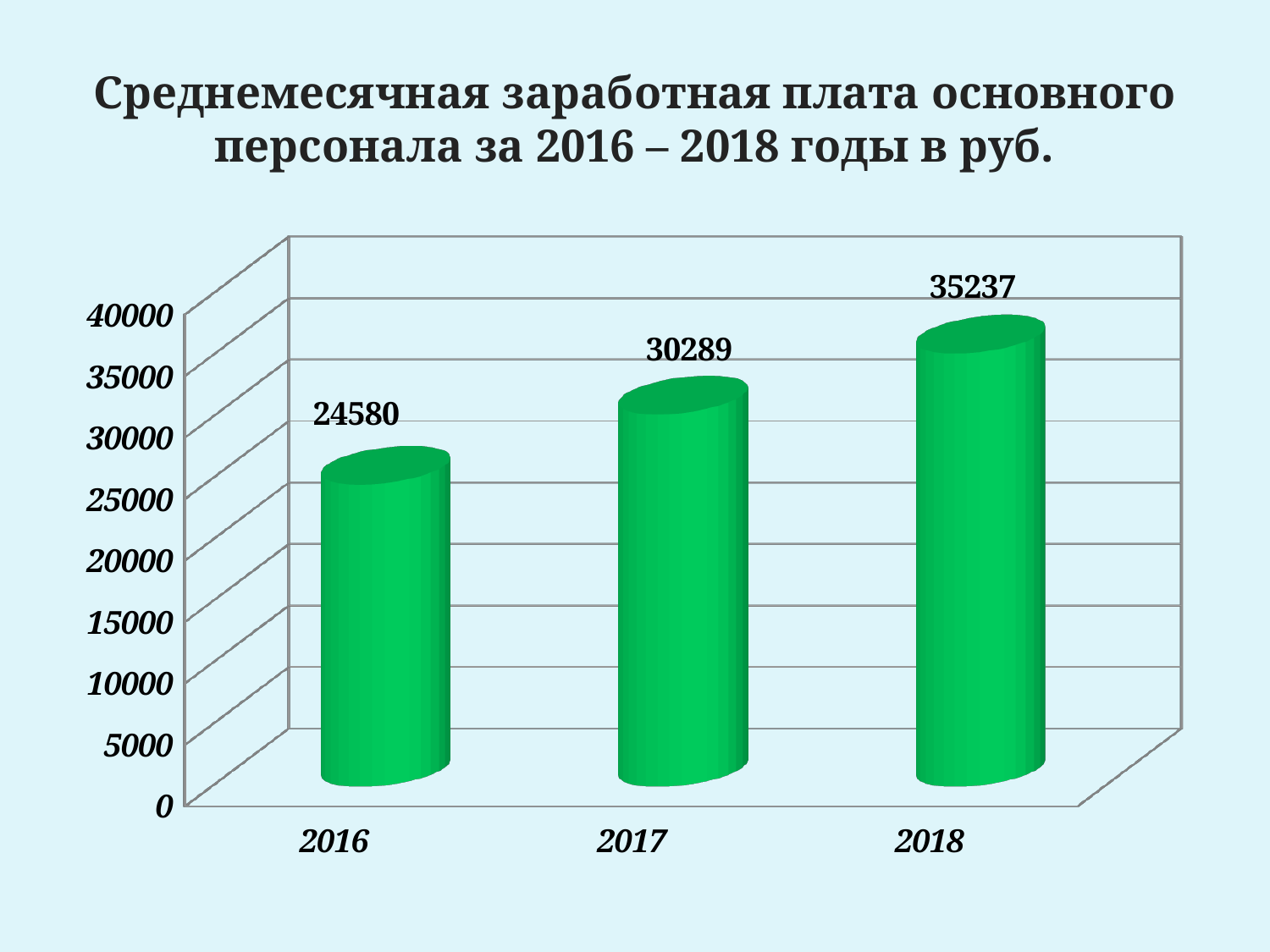
What is the difference between the values for 2018 and 2016? 10657 Which year has the lowest value? 2016 What is the value for 2016? 24580 How many years are shown on the x axis? 3 What is the difference between the values for 2017 and 2016? 5709 Which is larger, the value for 2017 or the value for 2018? 2018 Is the value for 2016 greater or less than 25000? less Do the values rise or fall from 2016 to 2018? rise What is the value for 2017? 30289 What is the value for 2018? 35237 What kind of chart is this? bar chart Which year has the highest value? 2018